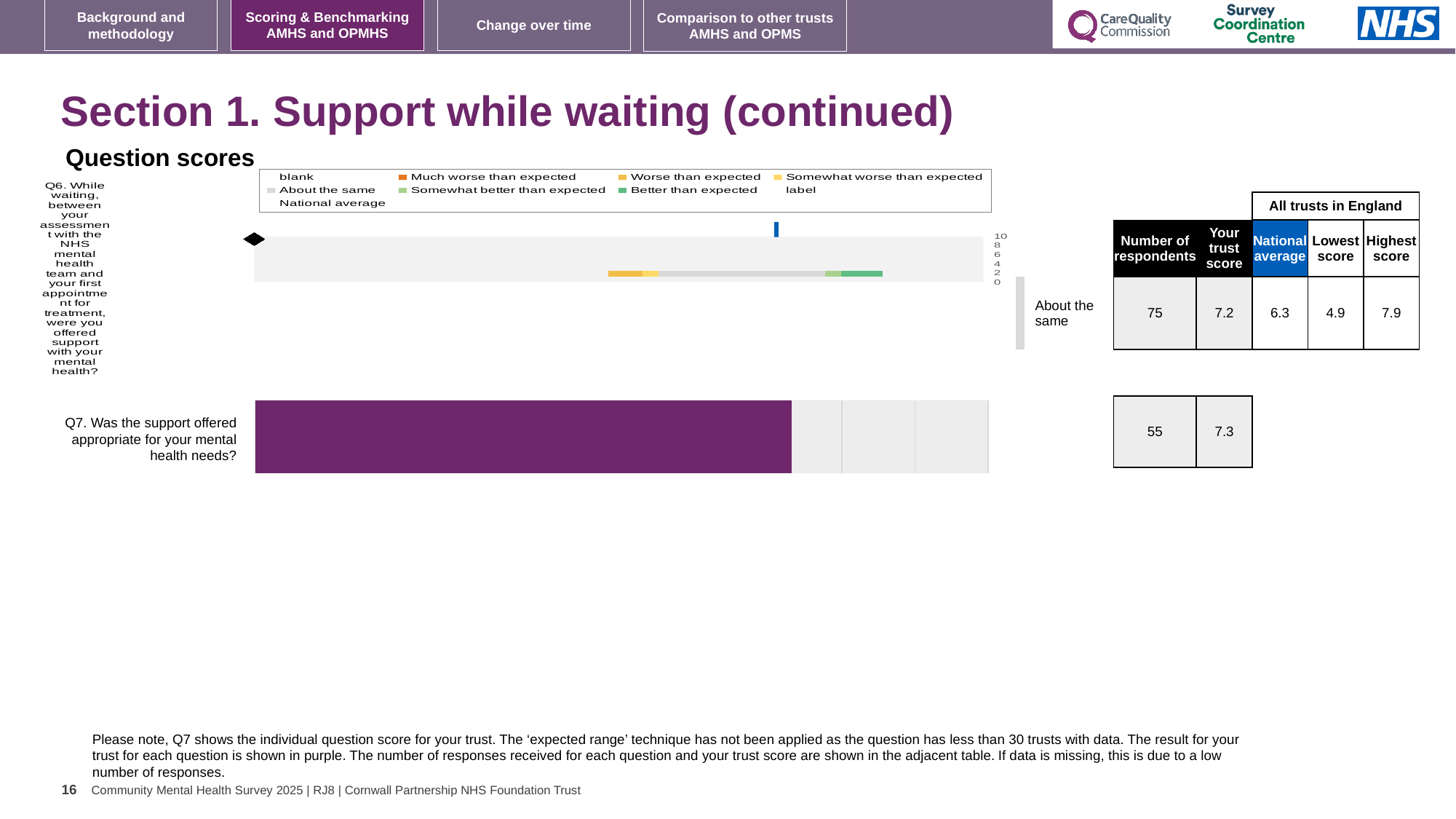
How many respondents answered Q7? 55 What is the lowest score among all trusts in England for Q6? 4.9 Is the value of the purple bar for Q7 greater or less than 6? greater What is the highest score among all trusts in England for Q6? 7.9 What is the trust score for Q7? 7.3 What is the difference between the trust score and the national average for Q6? 0.9 Which is larger for Q6: the trust score or the national average? trust score Which expected-range category is the trust's Q6 score labelled as? About the same What type of chart is used to show the question scores on this slide? bar chart How many respondents answered Q6? 75 What is the trust score for Q6 shown on the slide? 7.2 What is the national average score for Q6? 6.3